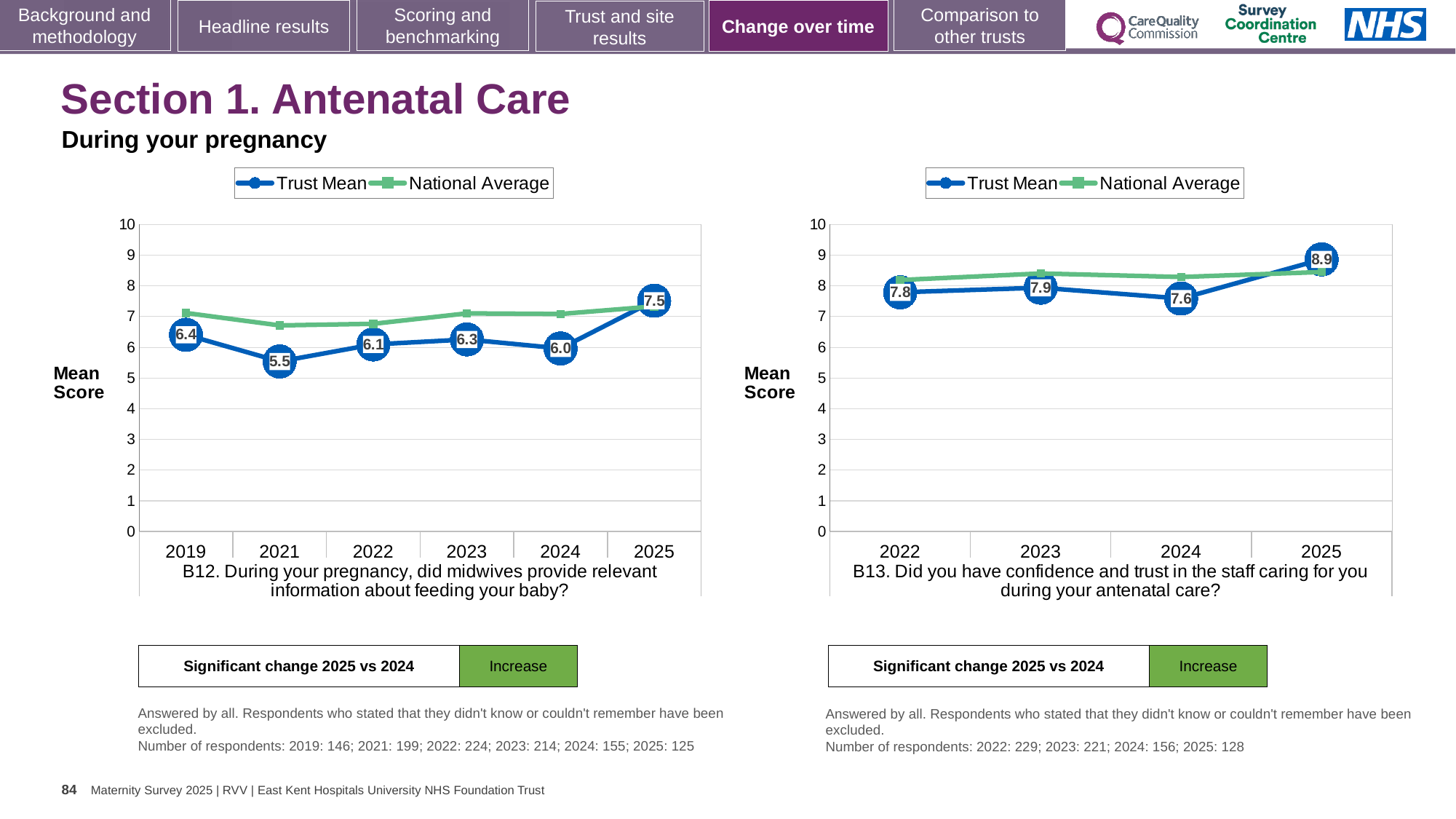
In the B12 chart (left), what is the difference between the Trust Mean scores for 2025 and 2024? 1.5 In the B12 chart (left), what is the Trust Mean score for 2021? 5.5 In the B12 chart (left), what is the Trust Mean score for 2025? 7.5 In the B12 chart (left), which year has the lowest Trust Mean score? 2021 How many series does the legend of the B13 chart (right) list? 2 In the B13 chart (right), which year has the highest Trust Mean score? 2025 In the B13 chart (right), is the Trust Mean for 2023 larger or smaller than the Trust Mean for 2022? larger In the B13 chart (right), what is the Trust Mean score for 2024? 7.6 In the B12 chart (left), which year has the highest Trust Mean score? 2025 In the B12 chart (left), how many years are shown on the x axis? 6 In the B13 chart (right), what is the difference between the Trust Mean scores for 2025 and 2024? 1.3